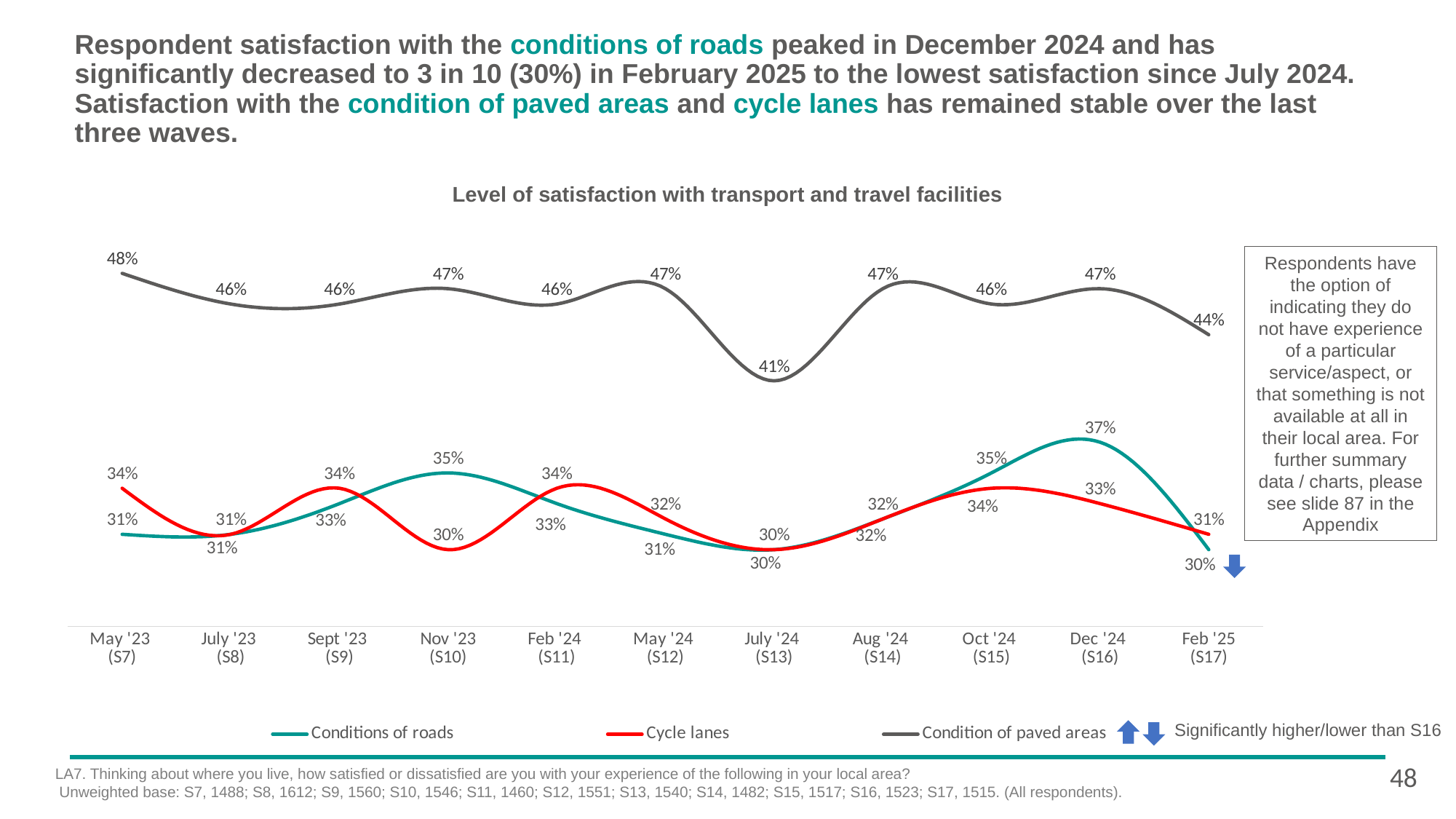
What is the difference between Conditions of roads in Dec '24 (S16) and Feb '25 (S17)? 7 percentage points What is the satisfaction value for Conditions of roads in Dec '24 (S16)? 37% In which wave is satisfaction with Condition of paved areas highest? May '23 (S7) Which series has the higher value in Feb '25 (S17): Conditions of roads or Cycle lanes? Cycle lanes In which wave is satisfaction with Condition of paved areas lowest? July '24 (S13) How many survey waves are plotted along the x axis? 11 What is the title of the chart? Level of satisfaction with transport and travel facilities How does satisfaction with Conditions of roads change from Dec '24 (S16) to Feb '25 (S17)? It falls What is the satisfaction value for Condition of paved areas in July '24 (S13)? 41% What type of chart is shown on the slide? Line chart What is the satisfaction value for Cycle lanes in Nov '23 (S10)? 30% How many series does the legend list? 3